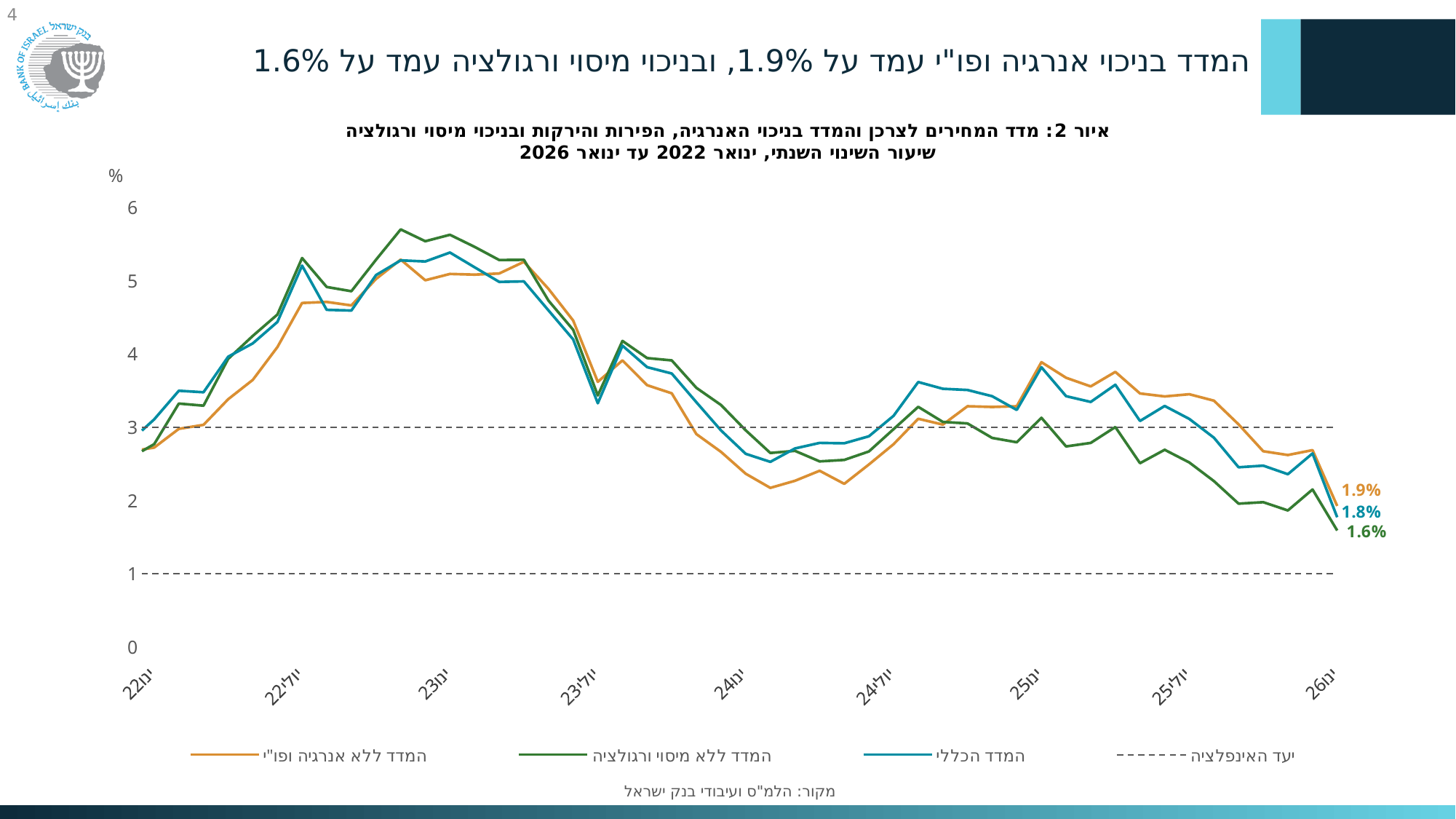
How many series does the legend list? 4 What is the latest value (January 2026) of the series המדד ללא אנרגיה ופו"י? 1.9% What type of chart is shown on the slide? line chart At January 2026, which is larger: המדד הכללי or המדד ללא מיסוי ורגולציה? המדד הכללי Between which two values do the dashed lines marking יעד האינפלציה lie on the y axis? 1 and 3 Which series has the lowest value at the end of the chart (January 2026)? המדד ללא מיסוי ורגולציה What is the latest value (January 2026) of the series המדד ללא מיסוי ורגולציה? 1.6% What is the latest value (January 2026) of the series המדד הכללי? 1.8% What is the difference between the January 2026 values of המדד ללא אנרגיה ופו"י and המדד ללא מיסוי ורגולציה? 0.3 percentage points Which series has the highest value at the end of the chart (January 2026)? המדד ללא אנרגיה ופו"י Is the value of המדד ללא מיסוי ורגולציה in January 2023 greater or less than 5? greater Do the series values rise or fall between July 2023 and January 2024? fall